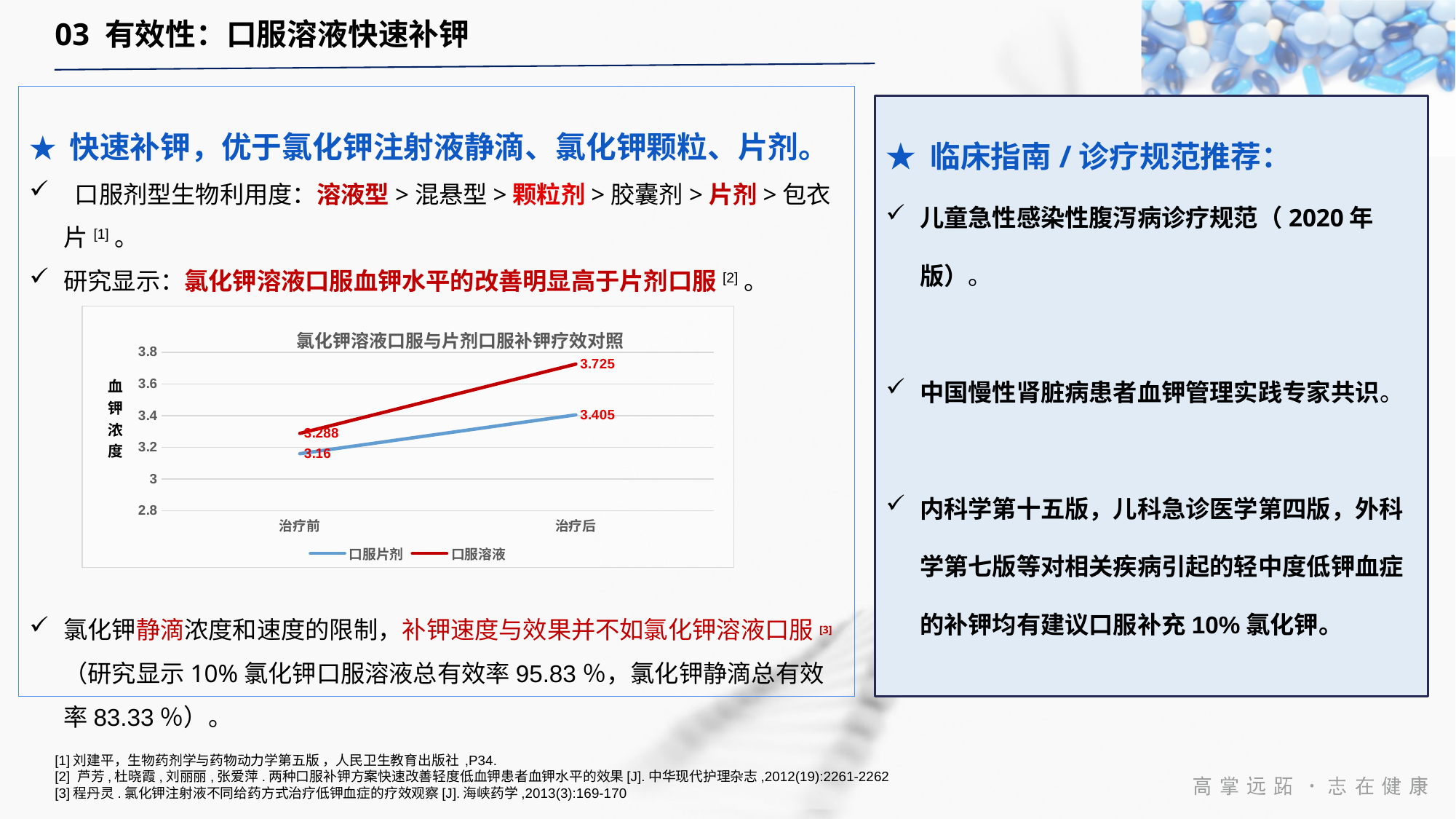
What is the value for 口服片剂 at 治疗后? 3.405 Do the values for 口服片剂 rise or fall from 治疗前 to 治疗后? rise What is the value for 口服溶液 at 治疗前? 3.288 Which colour is used for the 口服溶液 series in the chart? red Which series has the higher value at 治疗后, 口服溶液 or 口服片剂? 口服溶液 How many categories are shown on the x axis of the chart? 2 What is the difference between 口服溶液 and 口服片剂 at 治疗后? 0.32 What is the value for 口服片剂 at 治疗前? 3.16 What is the value for 口服溶液 at 治疗后? 3.725 What is the title of the chart? 氯化钾溶液口服与片剂口服补钾疗效对照 What type of chart is shown on the slide? line chart How many series does the chart legend list? 2